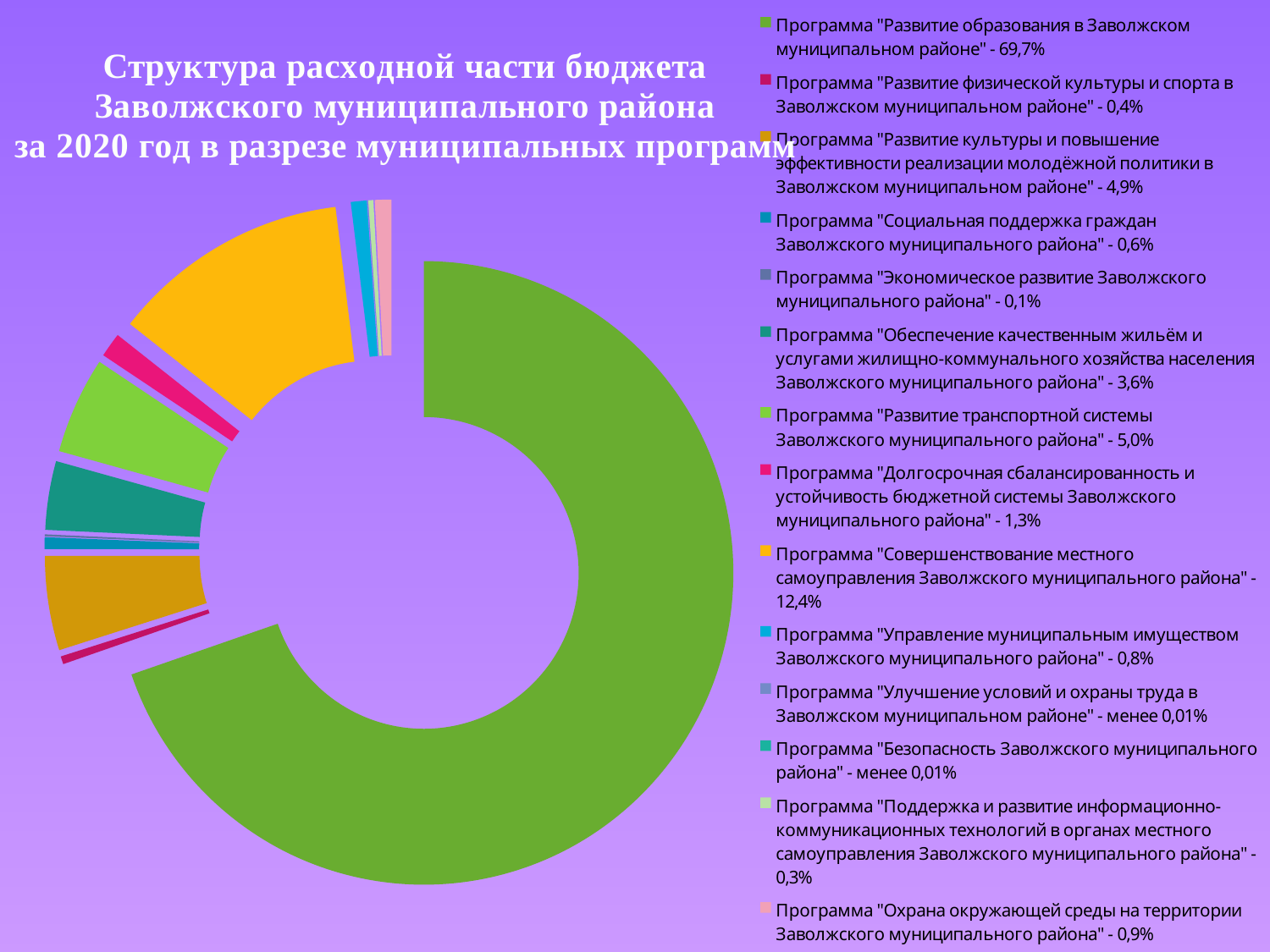
What share is shown for the programme "Обеспечение качественным жильём и услугами жилищно-коммунального хозяйства населения Заволжского муниципального района"? 3,6% What share is shown for the programme "Совершенствование местного самоуправления Заволжского муниципального района"? 12,4% Which has the larger share: the programme "Социальная поддержка граждан" or the programme "Управление муниципальным имуществом"? Программа "Управление муниципальным имуществом" (0,8%) Which programme has the largest share of the budget expenditure? Программа "Развитие образования в Заволжском муниципальном районе" What type of chart is shown on the slide? Pie (doughnut) chart What share of the budget expenditure goes to the programme "Развитие образования в Заволжском муниципальном районе"? 69,7% What is the difference in share between the programme "Развитие образования" (69,7%) and the programme "Совершенствование местного самоуправления" (12,4%)? 57,3 percentage points What year does the chart title say the budget expenditure structure refers to? 2020 What share is shown for the programme "Охрана окружающей среды на территории Заволжского муниципального района"? 0,9% Which has the larger share: the programme "Развитие транспортной системы" or the programme "Развитие культуры и повышение эффективности реализации молодёжной политики"? Программа "Развитие транспортной системы" (5,0%) What share is shown for the programme "Развитие транспортной системы Заволжского муниципального района"? 5,0% How many municipal programmes are listed in the chart legend? 14